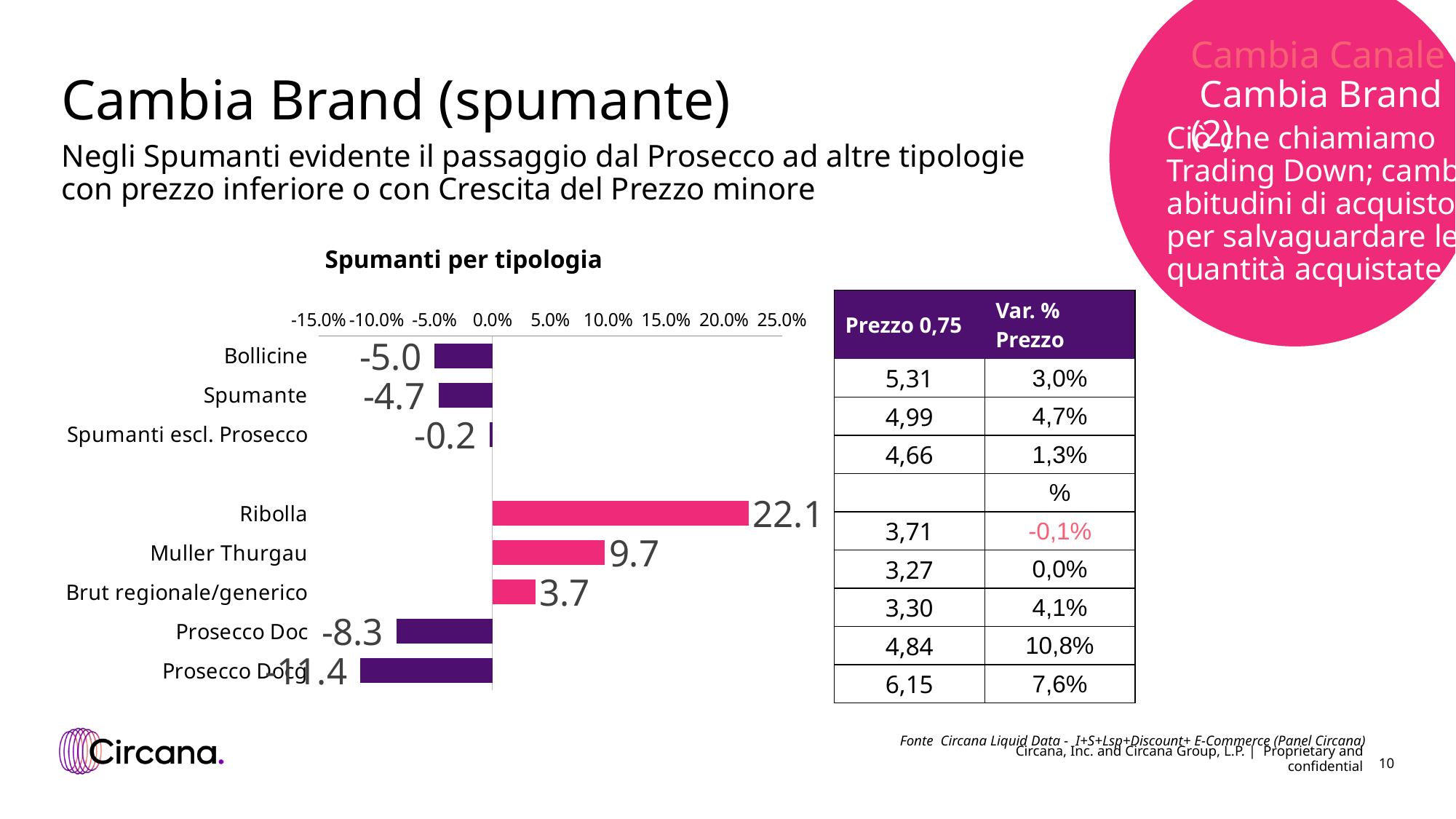
How many categories are plotted in the Spumanti per tipologia chart? 8 Is the value for Ribolla in the Spumanti per tipologia chart greater or less than 20.0%? greater What is the value shown for Prosecco Doc in the Spumanti per tipologia chart? -8.3 What is the value shown for Ribolla in the Spumanti per tipologia chart? 22.1 What is the value shown for Spumanti escl. Prosecco in the Spumanti per tipologia chart? -0.2 Which has the larger value in the Spumanti per tipologia chart, Brut regionale/generico or Muller Thurgau? Muller Thurgau Which category has the highest value in the Spumanti per tipologia chart? Ribolla What is the value shown for Muller Thurgau in the Spumanti per tipologia chart? 9.7 What is the difference between the values for Ribolla and Muller Thurgau in the Spumanti per tipologia chart? 12.4 What is the title of the chart on the slide? Spumanti per tipologia What kind of chart is the Spumanti per tipologia chart? Bar chart Which category has the lowest value in the Spumanti per tipologia chart? Prosecco Docg